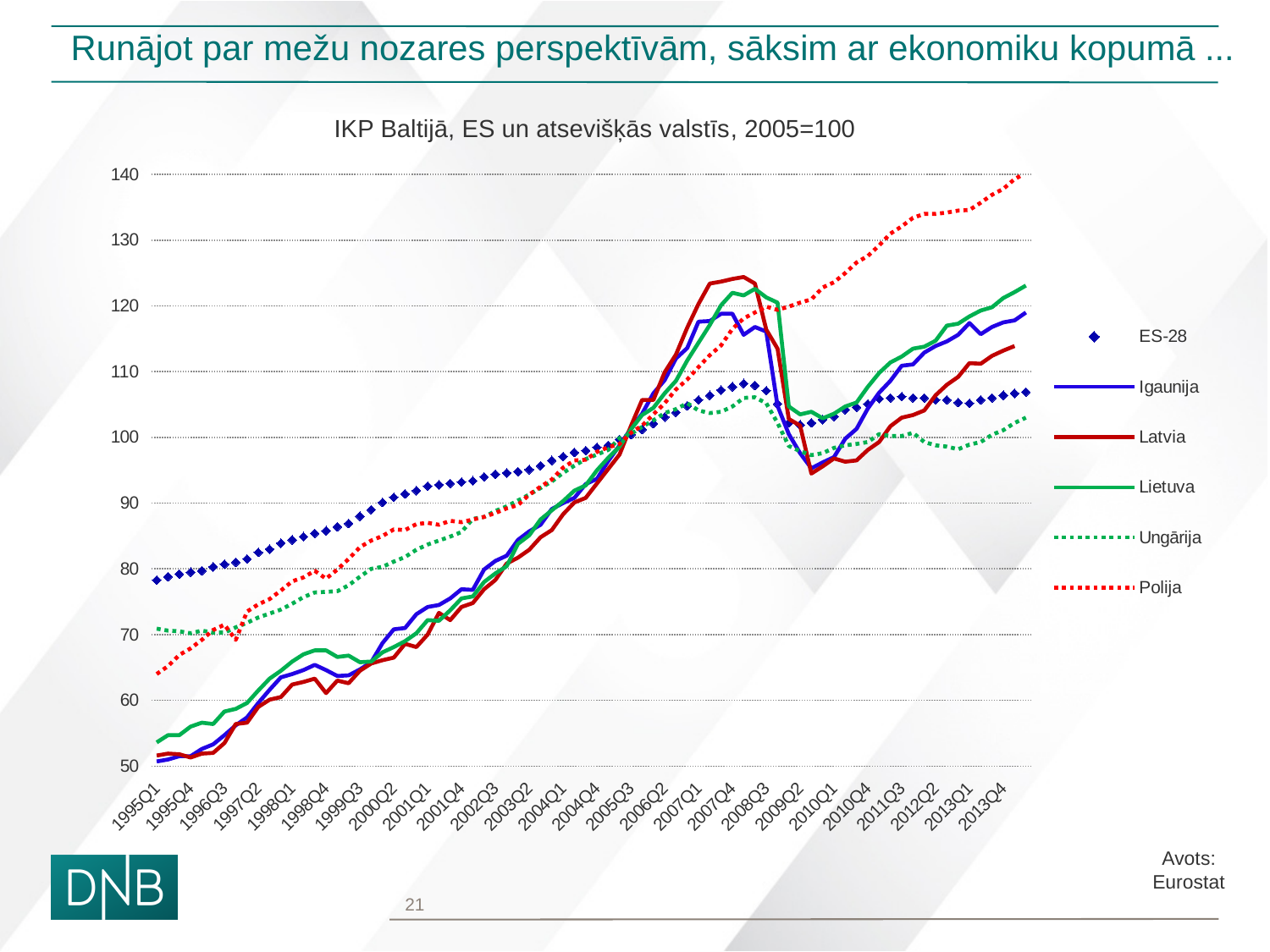
At 2013Q4, which is higher: Polija or Latvia? Polija Is the value for Ungārija at 2013Q4 greater or less than 110? less Does the Latvia series rise or fall between 2007Q4 and 2009Q4? fall What is the title of the chart? IKP Baltijā, ES un atsevišķās valstīs, 2005=100 At 1995Q1, which is higher: ES-28 or Latvia? ES-28 What kind of chart is shown on the slide? line chart Which series is drawn as a red dotted line? Polija Is the value for Polija at 2013Q4 greater or less than 130? greater How many series does the legend list? 6 Is the value for Latvia at 1995Q1 greater or less than 60? less Which series has the highest value at 2013Q4? Polija